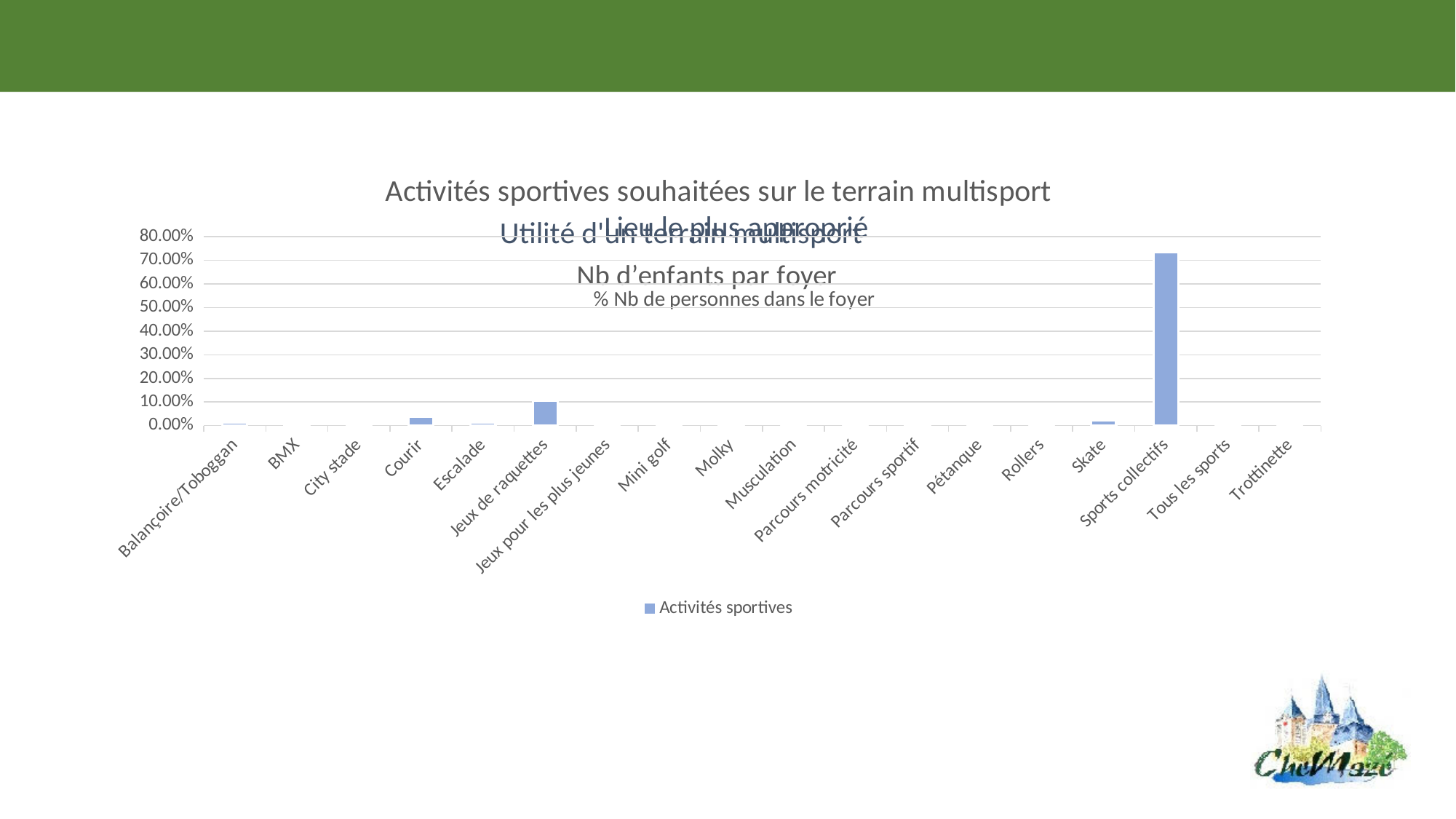
Which category has the highest value in the chart? Sports collectifs Which is larger, the value for Jeux de raquettes or the value for Courir? Jeux de raquettes How many categories are shown on the x axis of the chart? 18 What is the name of the series listed in the legend? Activités sportives What is the highest tick value shown on the y axis? 80.00% Which is larger, the value for Courir or the value for Skate? Courir What kind of chart is shown on the slide? bar chart Is the value for Sports collectifs greater or less than 60.00%? greater Is the value for Courir greater or less than 10.00%? less Which is larger, the value for Sports collectifs or the value for Jeux de raquettes? Sports collectifs Is the value for Jeux de raquettes greater or less than 20.00%? less How many series does the legend list? 1